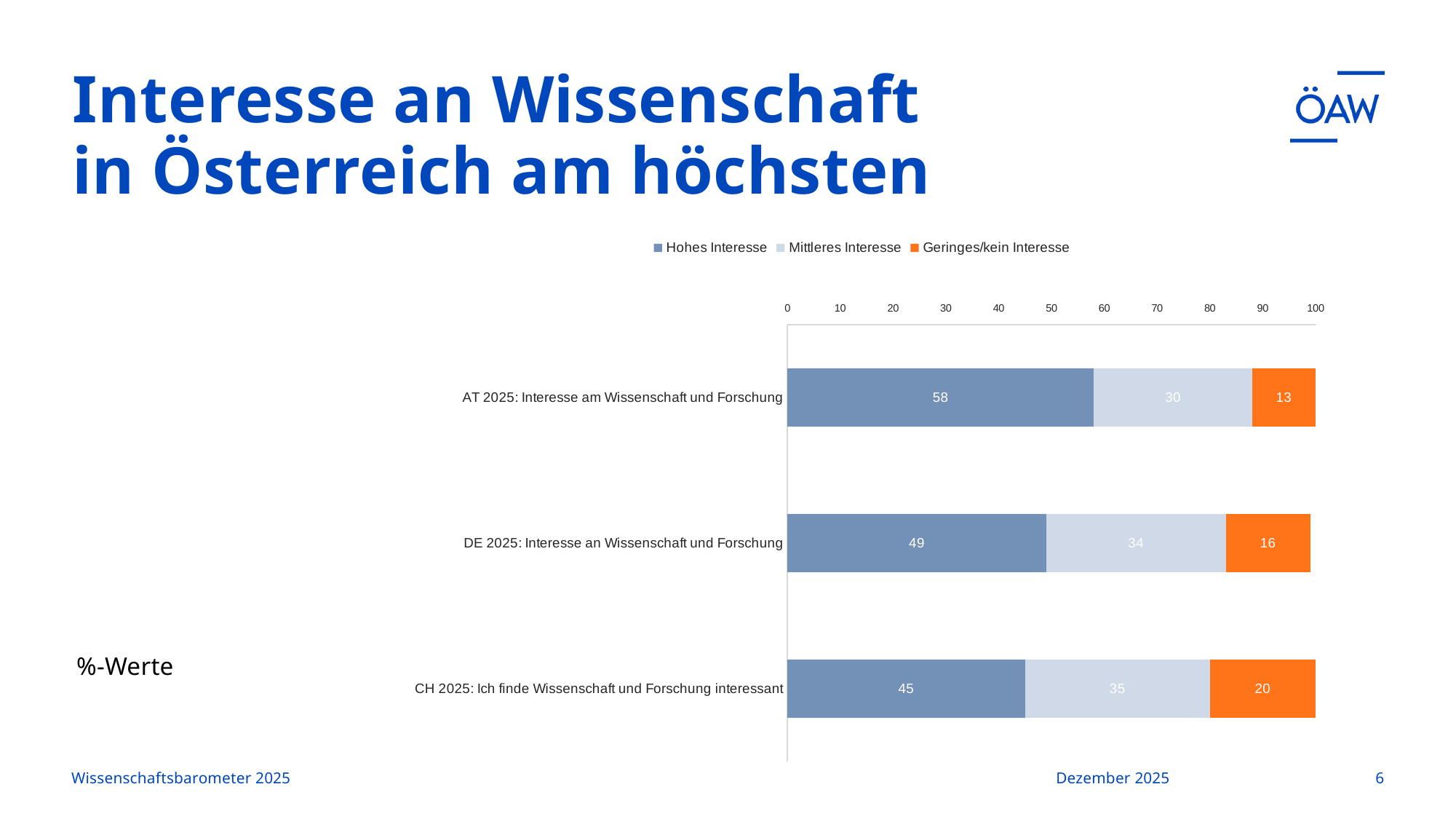
Which country bar has the highest value for "Hohes Interesse"? AT 2025 How many bars (countries) are shown in the chart? 3 What is the total of the DE 2025 stacked bar? 99 How many series does the legend list? 3 Which is larger: "Mittleres Interesse" for CH 2025 or for AT 2025? CH 2025 What is the value for "Geringes/kein Interesse" in the CH 2025 bar? 20 What kind of chart is shown on the slide? Stacked bar chart What is the value for "Mittleres Interesse" in the DE 2025 bar? 34 Which colour represents "Geringes/kein Interesse" in the chart? Orange Which country bar has the lowest value for "Geringes/kein Interesse"? AT 2025 What is the difference between the "Hohes Interesse" values for AT 2025 and CH 2025? 13 What is the value for "Hohes Interesse" in the AT 2025 bar? 58